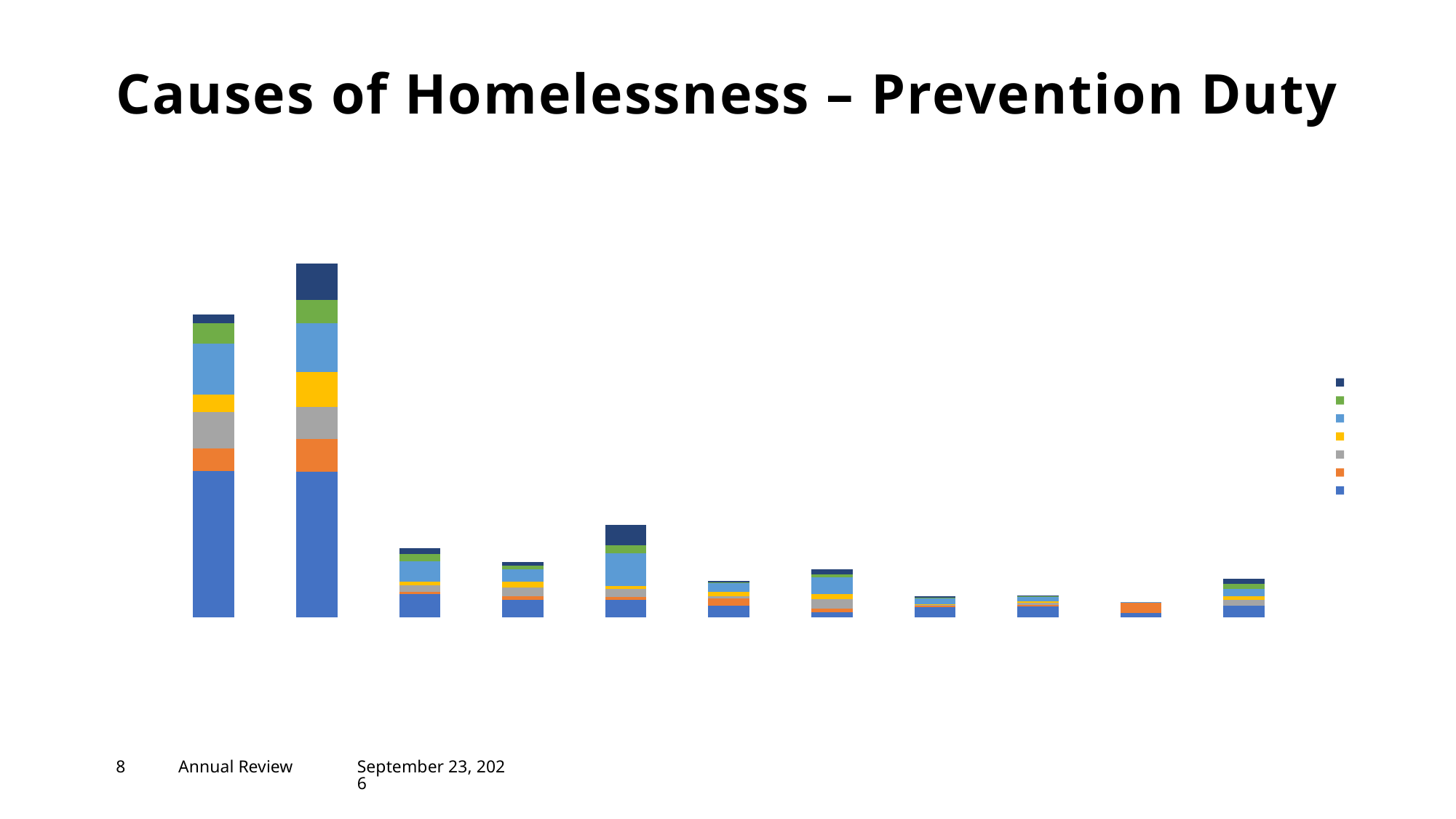
How many series does the legend list? 7 What kind of chart is shown on the slide? stacked bar chart How many bars are plotted in the chart? 11 Is the first bar from the left taller or shorter than the second bar? shorter Which bar, counting from the left, is the tallest? the second bar Which is taller, the second bar from the left or the fifth bar from the left? the second bar What is the title of the slide containing the chart? Causes of Homelessness – Prevention Duty Which is taller, the third bar from the left or the fifth bar from the left? the fifth bar What colour is the bottom segment of the stacked bars? blue